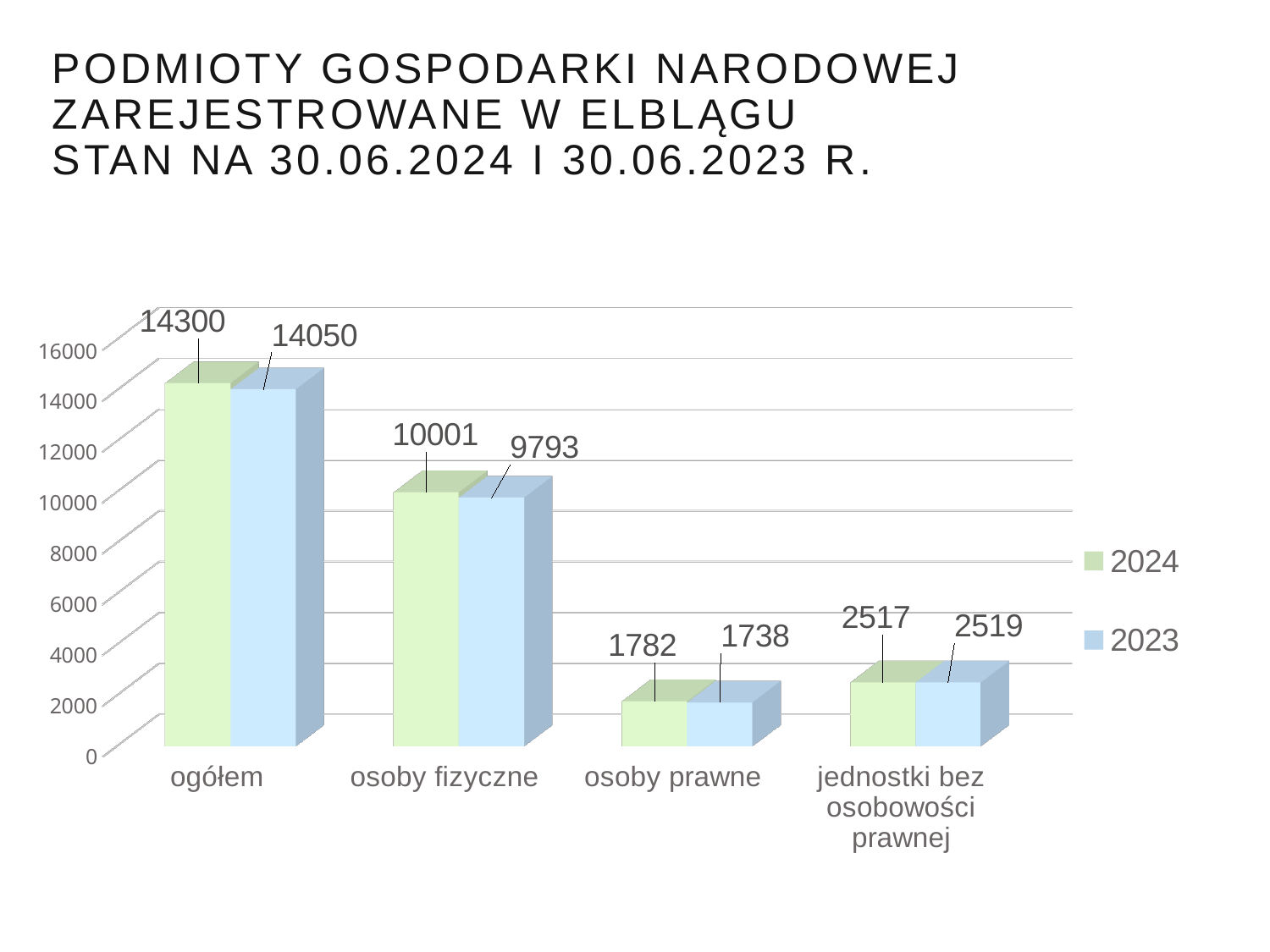
What is the value for osoby fizyczne in the 2023 series? 9793 How many categories are shown on the x axis? 4 What is the difference between the 2024 and 2023 values for osoby fizyczne? 208 Which category has the highest value in the 2024 series? ogółem What is the value for jednostki bez osobowości prawnej in the 2023 series? 2519 What is the value for ogółem in the 2024 series? 14300 What kind of chart is shown on the slide? Bar chart What is the value for osoby prawne in the 2024 series? 1782 What is the difference between the 2024 and 2023 values for ogółem? 250 How many series does the legend list? 2 Which category has the lowest value in the 2023 series? osoby prawne Is the 2024 value for osoby fizyczne larger than the 2023 value for osoby fizyczne? Yes